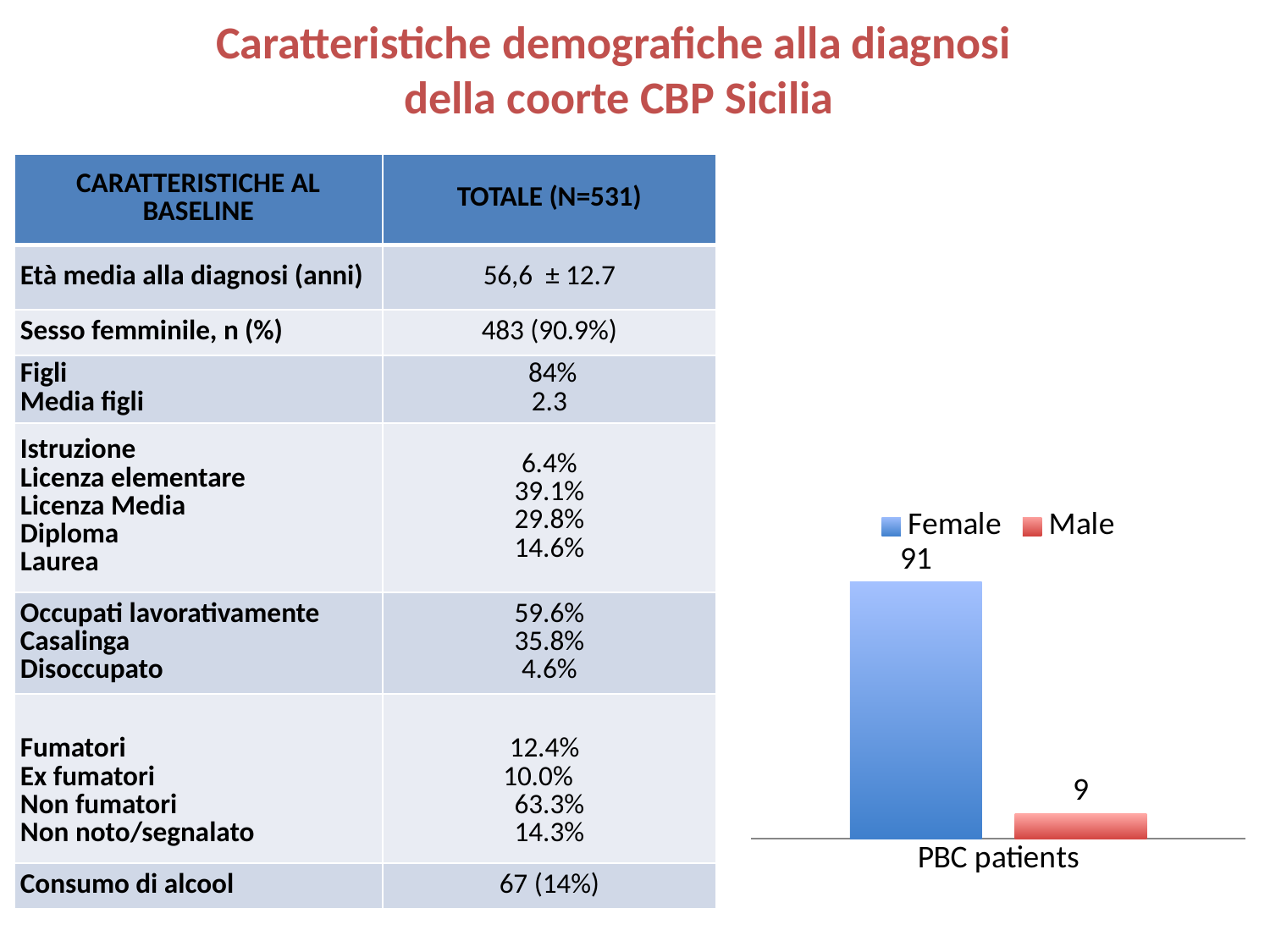
What is the value for Female in the chart? 91 What colour is the Male bar in the chart? red How many categories are shown on the x axis of the chart? 1 Which series has the highest value in the chart? Female How many series does the chart legend list? 2 What is the difference between the Female and Male values in the chart? 82 Which series has the lowest value in the chart? Male Which is larger in the chart, Female or Male? Female What is the value for Male in the chart? 9 What is the category label on the x axis of the chart? PBC patients What kind of chart is shown on the slide? bar chart What is the total of the Female and Male values in the chart? 100